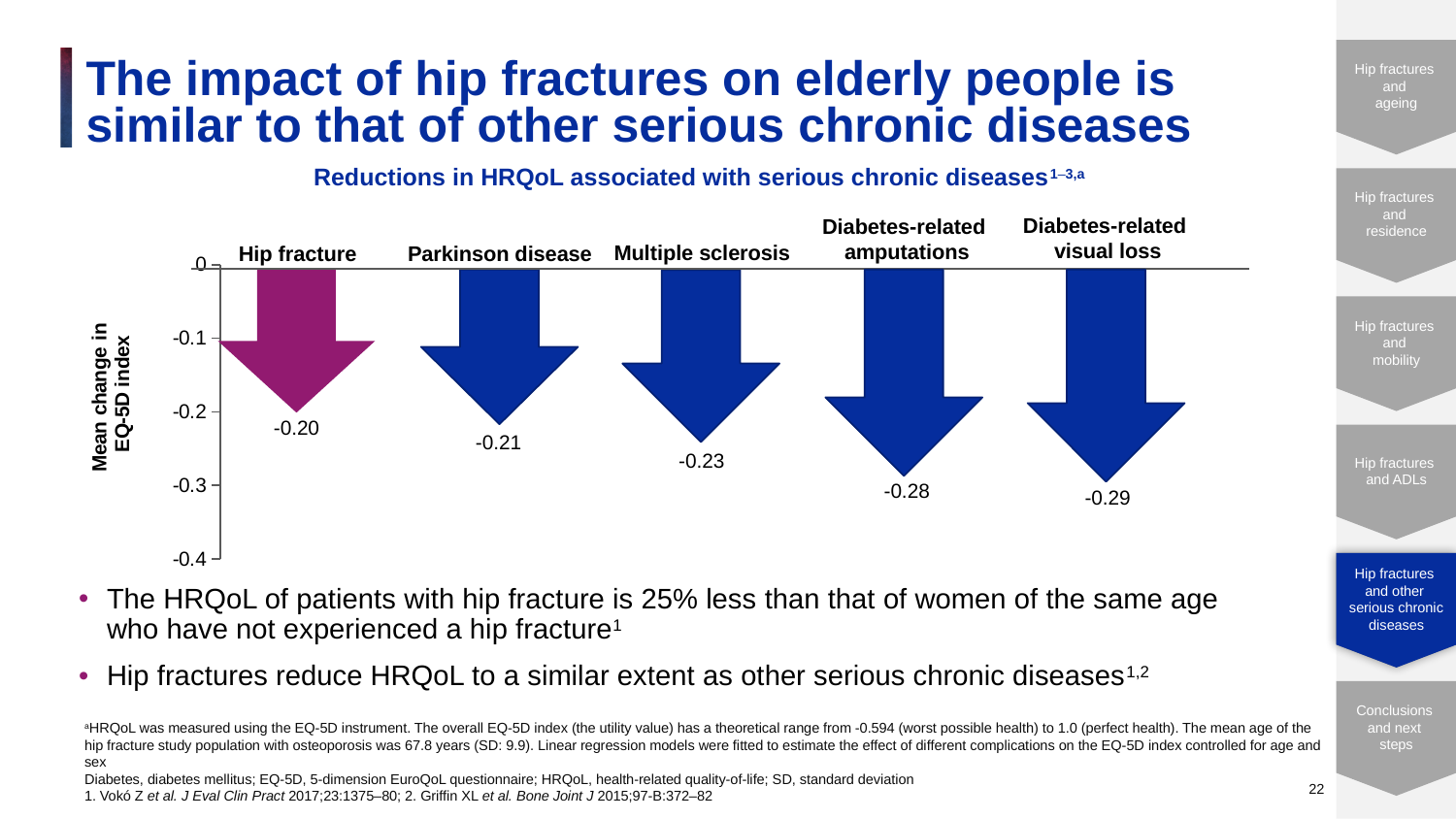
What is the mean change in EQ-5D index for Parkinson disease? -0.21 What is the mean change in EQ-5D index for diabetes-related amputations? -0.28 Which has a larger reduction in EQ-5D index: multiple sclerosis or diabetes-related amputations? Diabetes-related amputations Which condition shows the largest reduction in EQ-5D index? Diabetes-related visual loss Do the values become more negative or less negative moving from left to right across the chart? More negative What is the mean change in EQ-5D index for diabetes-related visual loss? -0.29 Which condition shows the smallest reduction in EQ-5D index? Hip fracture How many conditions are shown in the chart? 5 What is the mean change in EQ-5D index for hip fracture? -0.20 What is the difference between the EQ-5D index change for diabetes-related visual loss and for hip fracture? 0.09 What is the mean change in EQ-5D index for multiple sclerosis? -0.23 What is the title of the chart? Reductions in HRQoL associated with serious chronic diseases